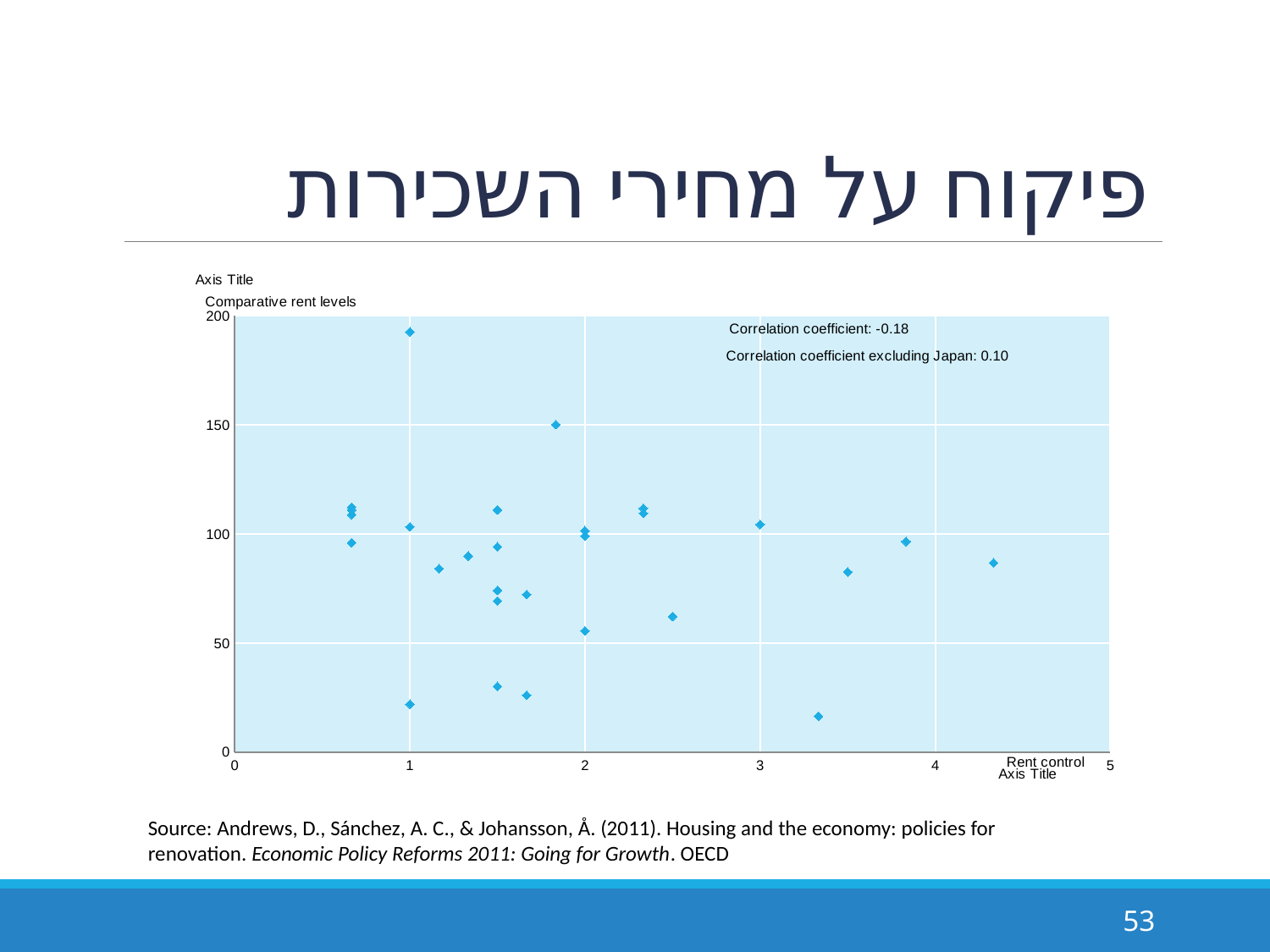
Is the comparative rent level of the rightmost point (rent control above 4) greater or less than 100? less What is the correlation coefficient excluding Japan, as stated on the chart? 0.10 What kind of chart is shown on the slide? scatter chart Is the comparative rent level of the point with rent control of about 1 that lies highest on the chart greater or less than 150? greater What is the highest value shown on the vertical axis of the chart? 200 What correlation coefficient is stated on the chart for all countries? -0.18 Is the comparative rent level of the lowest point on the chart greater or less than 50? less What is the highest value shown on the horizontal axis of the chart? 5